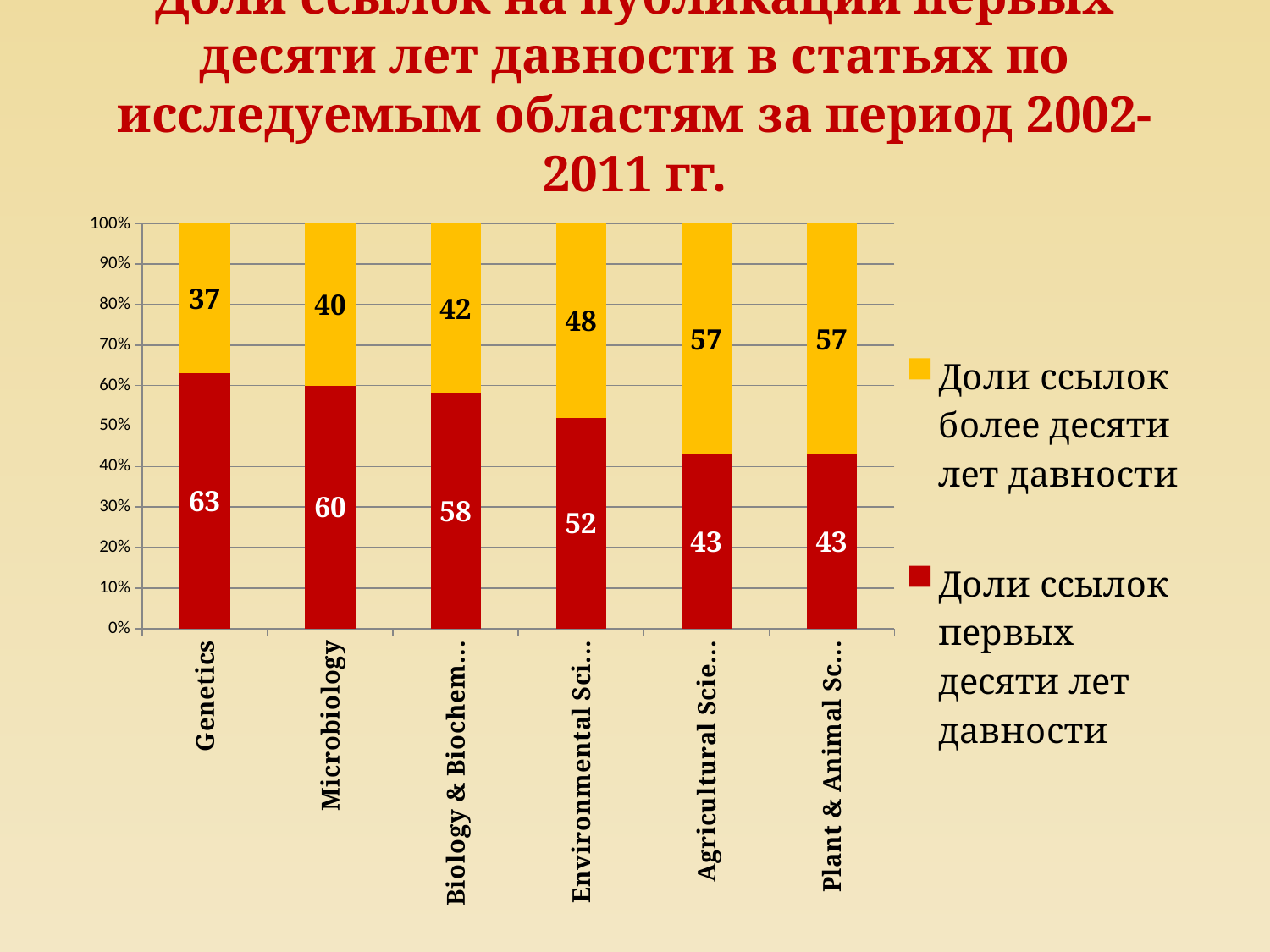
Does the 'Доли ссылок первых десяти лет давности' series rise or fall from Genetics to Plant & Animal Sc... along the x axis? Fall What is the value of the 'Доли ссылок первых десяти лет давности' series for Genetics? 63 Which has the larger 'Доли ссылок первых десяти лет давности' value, Microbiology or Environmental Sci...? Microbiology What colour represents 'Доли ссылок более десяти лет давности' in the chart? Yellow What is the value of the 'Доли ссылок более десяти лет давности' series for Environmental Sci...? 48 What is the value of the 'Доли ссылок более десяти лет давности' series for Microbiology? 40 How many categories are shown on the x axis of the chart? 6 What kind of chart is shown on the slide? Stacked bar chart Which category has the lowest value for 'Доли ссылок более десяти лет давности'? Genetics What is the difference between the 'Доли ссылок первых десяти лет давности' values for Genetics and Microbiology? 3 How many series does the legend list? 2 Which category has the highest value for 'Доли ссылок первых десяти лет давности'? Genetics